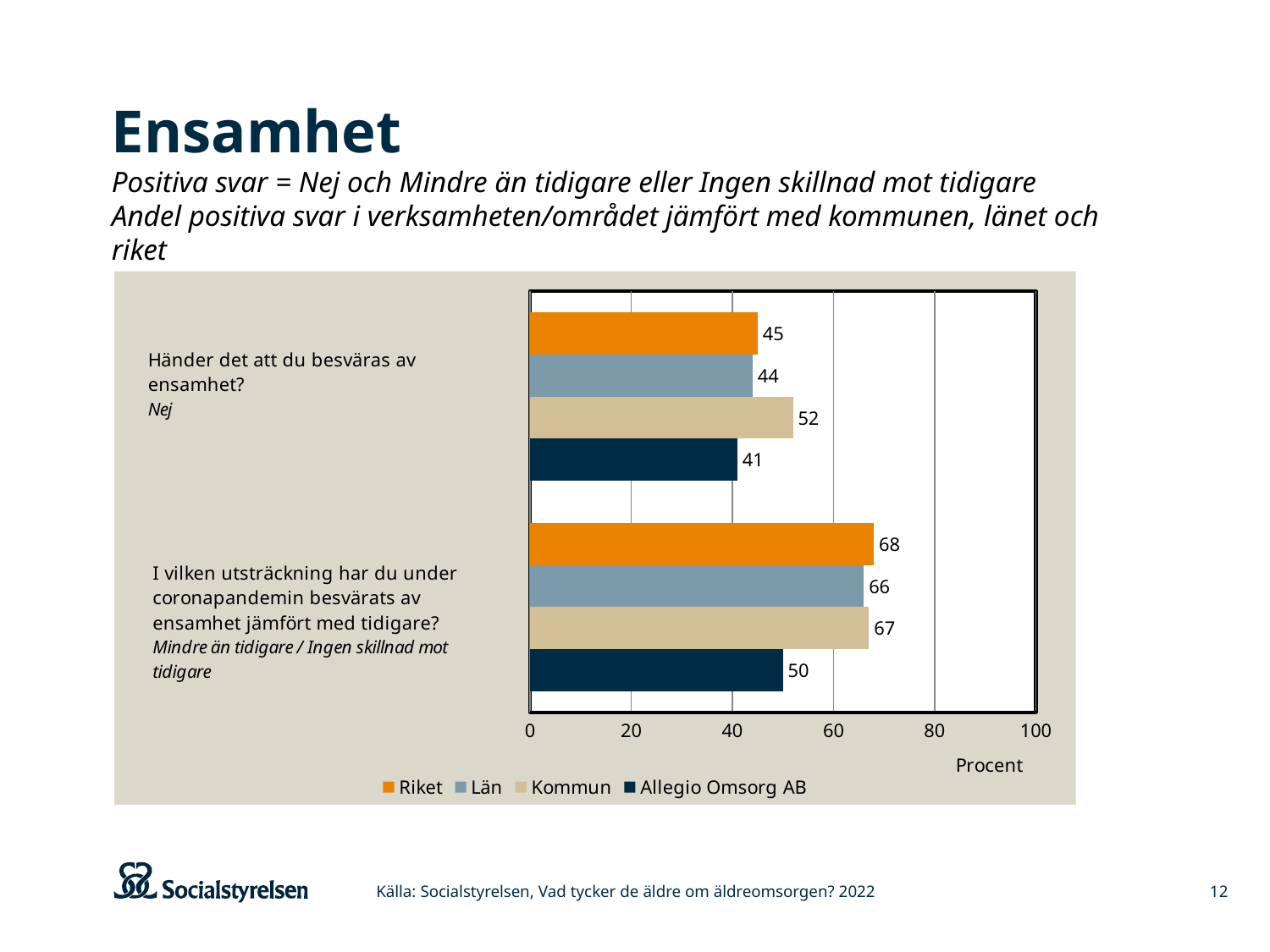
What is the difference between Kommun and Allegio Omsorg AB on the question "Händer det att du besväras av ensamhet?"? 11 Is the value for Län on the question "I vilken utsträckning har du under coronapandemin besvärats av ensamhet jämfört med tidigare?" greater or less than 60? greater How many series does the legend list? 4 What value is shown for Riket on the question "Händer det att du besväras av ensamhet?"? 45 Which is larger for the question "Händer det att du besväras av ensamhet?": Riket or Allegio Omsorg AB? Riket Which series has the lowest value for the question "I vilken utsträckning har du under coronapandemin besvärats av ensamhet jämfört med tidigare?"? Allegio Omsorg AB Which series has the highest value for the question "Händer det att du besväras av ensamhet?"? Kommun What is the label on the horizontal axis of the chart? Procent What value is shown for Allegio Omsorg AB on the question "I vilken utsträckning har du under coronapandemin besvärats av ensamhet jämfört med tidigare?"? 50 What kind of chart is shown on the slide? Bar chart What value is shown for Kommun on the question "Händer det att du besväras av ensamhet?"? 52 What is the difference between Riket and Allegio Omsorg AB on the question "I vilken utsträckning har du under coronapandemin besvärats av ensamhet jämfört med tidigare?"? 18